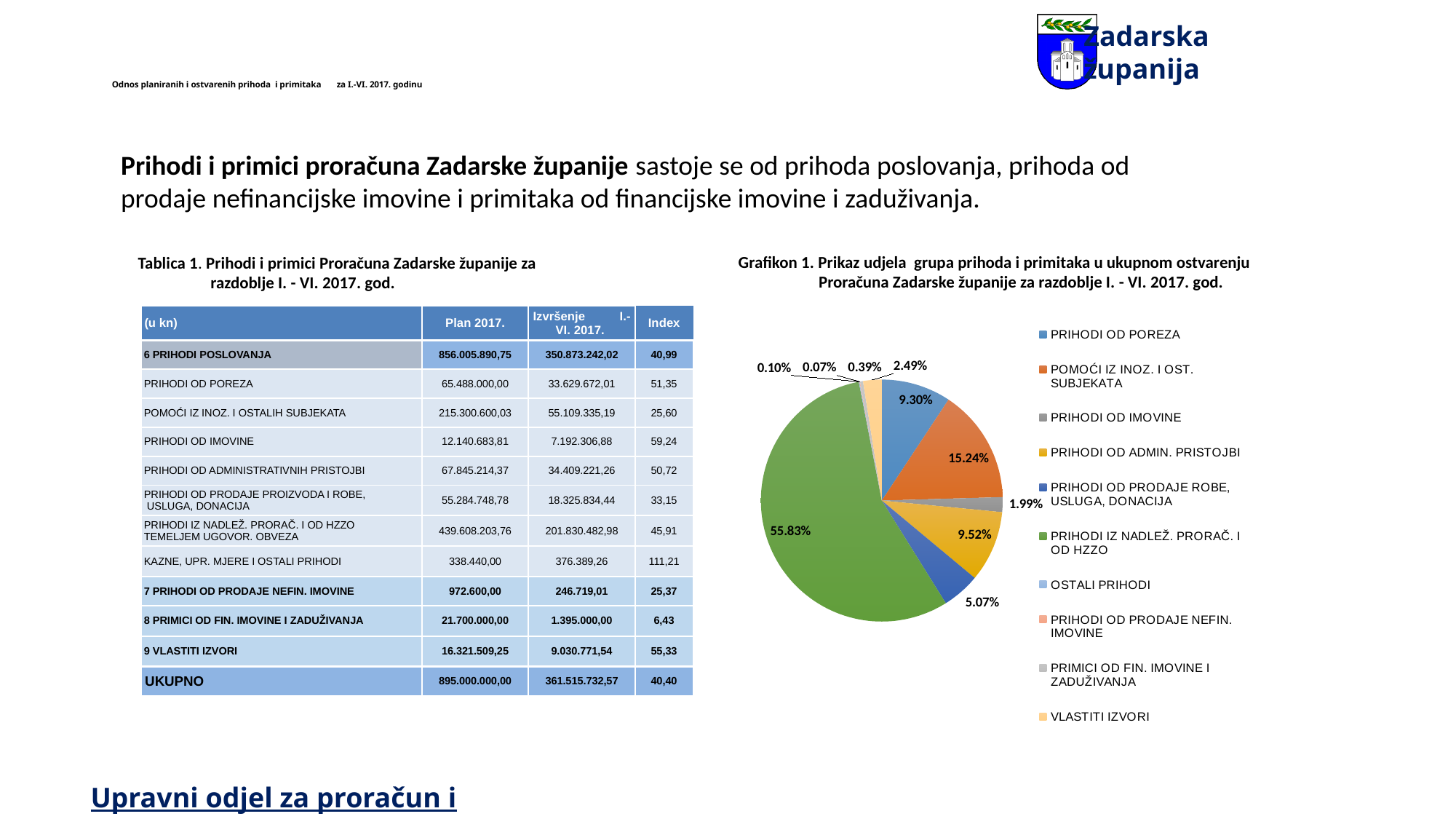
In Grafikon 1, what share does VLASTITI IZVORI have? 2.49% What kind of chart is Grafikon 1? pie chart In Grafikon 1, what is the difference between the share of POMOĆI IZ INOZ. I OST. SUBJEKATA and the share of PRIHODI OD ADMIN. PRISTOJBI? 5.72% In Grafikon 1, how many categories does the legend list? 10 In Grafikon 1, what is the share of the largest slice? 55.83% In Grafikon 1, what share does PRIHODI OD POREZA have? 9.30% In Grafikon 1, which is larger: the share of POMOĆI IZ INOZ. I OST. SUBJEKATA or the share of PRIHODI OD POREZA? POMOĆI IZ INOZ. I OST. SUBJEKATA In Grafikon 1, what share does PRIHODI OD PRODAJE ROBE, USLUGA, DONACIJA have? 5.07% In Grafikon 1, what share does POMOĆI IZ INOZ. I OST. SUBJEKATA have? 15.24% In Grafikon 1, what share does PRIHODI OD ADMIN. PRISTOJBI have? 9.52% In Grafikon 1, which category has the largest slice? PRIHODI IZ NADLEŽ. PRORAČ. I OD HZZO In Grafikon 1, what share does PRIHODI OD IMOVINE have? 1.99%